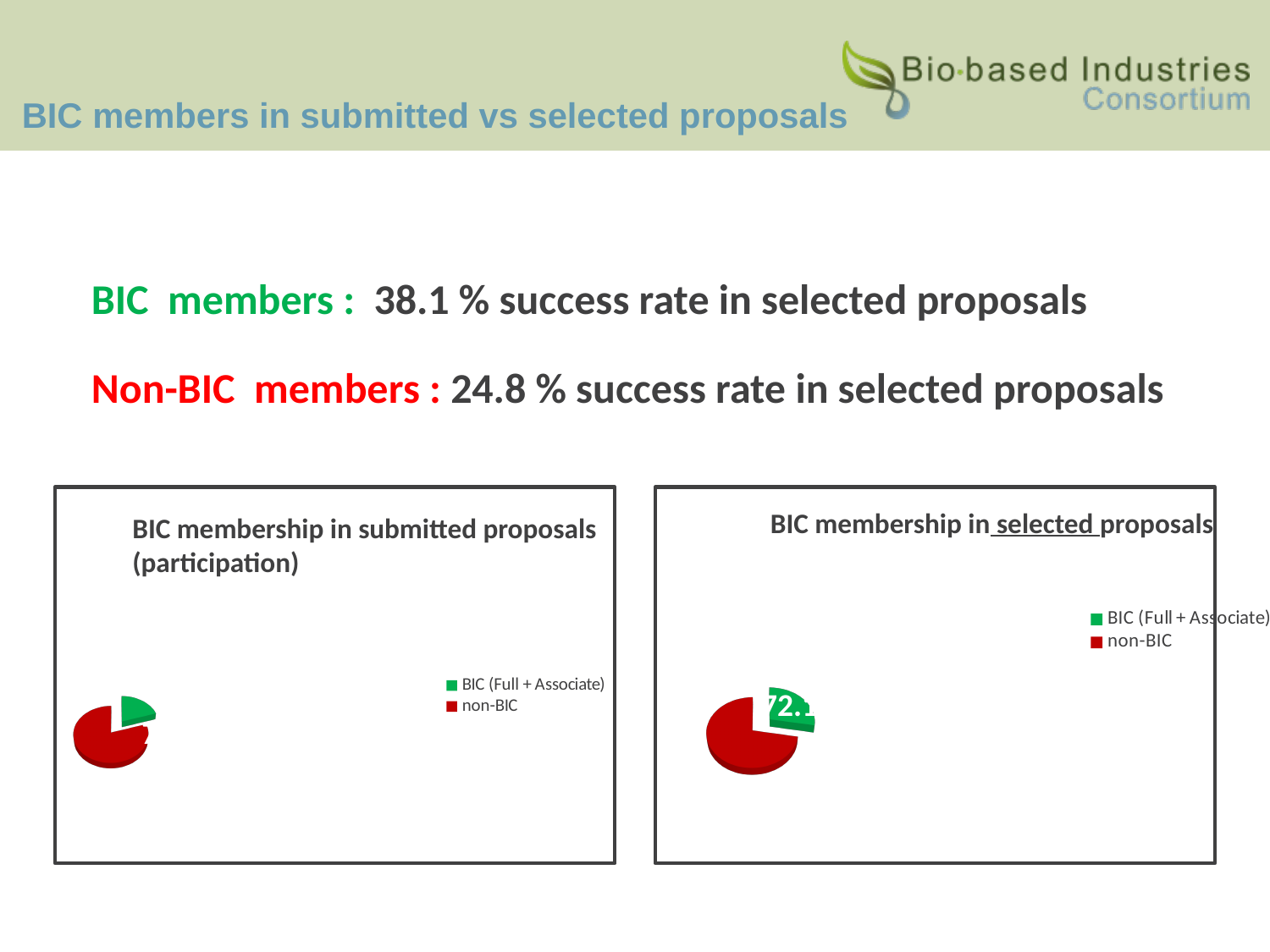
What kind of chart is the 'BIC membership in submitted proposals (participation)' chart? pie chart In the 'BIC membership in selected proposals' chart, which category has the smallest slice? BIC (Full + Associate) What kind of chart is the 'BIC membership in selected proposals' chart? pie chart In the 'BIC membership in submitted proposals (participation)' chart, which slice is larger: BIC (Full + Associate) or non-BIC? non-BIC In the 'BIC membership in selected proposals' chart, what colour represents non-BIC? red In the 'BIC membership in selected proposals' chart, how many entries does the legend list? 2 In the 'BIC membership in submitted proposals (participation)' chart, how many entries does the legend list? 2 In the 'BIC membership in submitted proposals (participation)' chart, how many slices does the pie have? 2 In the 'BIC membership in selected proposals' chart, which slice is larger: BIC (Full + Associate) or non-BIC? non-BIC In the 'BIC membership in submitted proposals (participation)' chart, what colour represents BIC (Full + Associate)? green In the 'BIC membership in submitted proposals (participation)' chart, which category has the largest slice? non-BIC